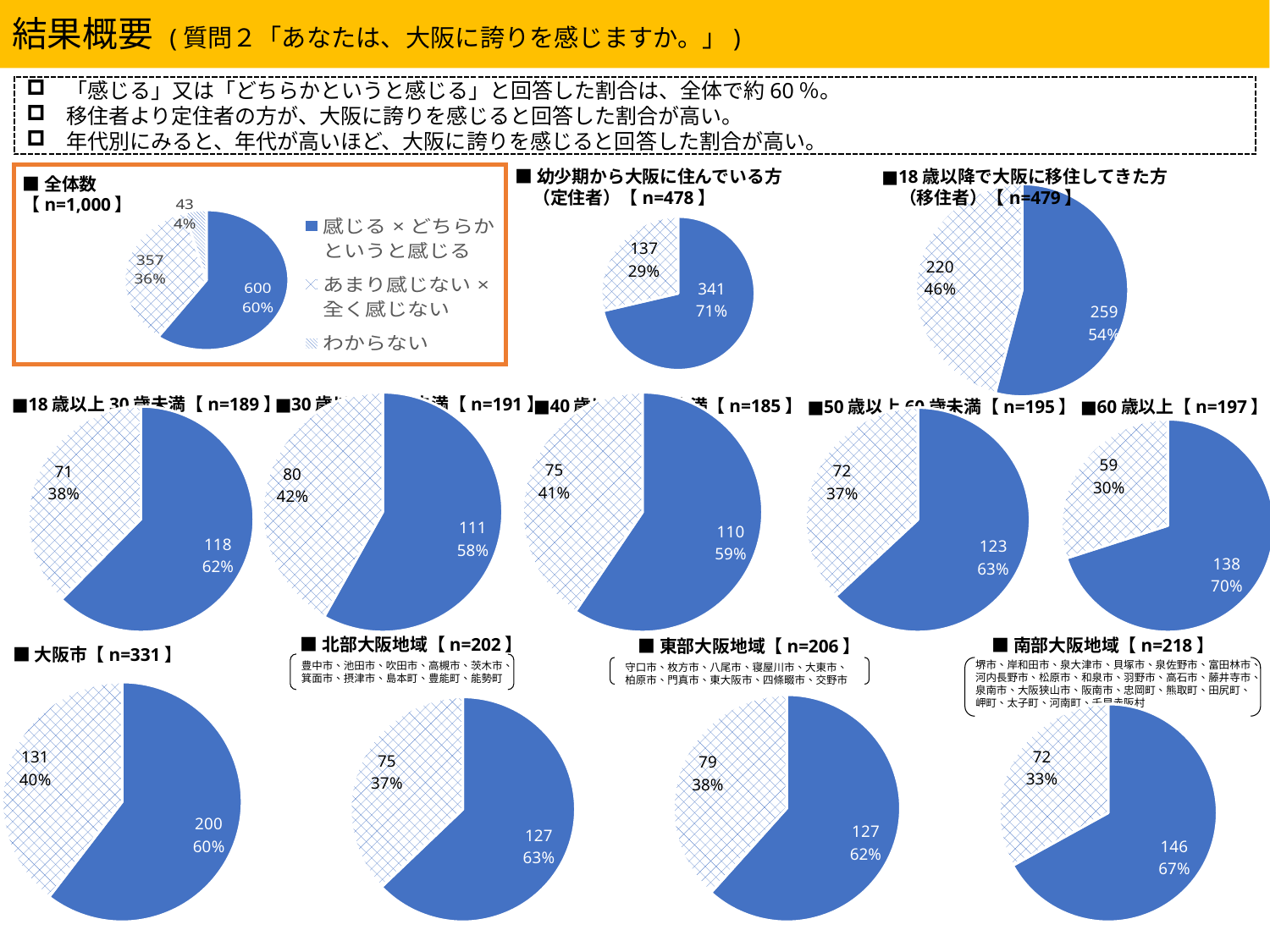
What is the difference in count between the two slices of the 50歳以上60歳未満【n=195】 pie chart? 51 Among the age-group pie charts (18歳以上30歳未満, 30歳以上, 40歳以上, 50歳以上60歳未満, 60歳以上), which has the highest percentage for the solid blue slice? 60歳以上【n=197】 How many slices does the 大阪市【n=331】 pie chart have? 2 In the 18歳以降で大阪に移住してきた方（移住者）【n=479】 pie chart, what percentage does the smaller slice represent? 46% In the 全体数【n=1,000】 pie chart, what percentage of respondents answered 感じる×どちらかというと感じる? 60% In the 南部大阪地域【n=218】 pie chart, what percentage does the solid blue slice represent? 67% Which has a larger percentage for the main (solid blue) slice: the 定住者【n=478】 chart or the 移住者【n=479】 chart? 定住者【n=478】 In the 60歳以上【n=197】 pie chart, what is the count for the solid blue slice? 138 What type of chart is used for the 幼少期から大阪に住んでいる方（定住者）【n=478】 data? Pie chart In the 幼少期から大阪に住んでいる方（定住者）【n=478】 pie chart, what is the count for the larger slice? 341 In the 全体数【n=1,000】 pie chart, how many respondents answered わからない? 43 How many entries does the legend of the 全体数【n=1,000】 pie chart list? 3